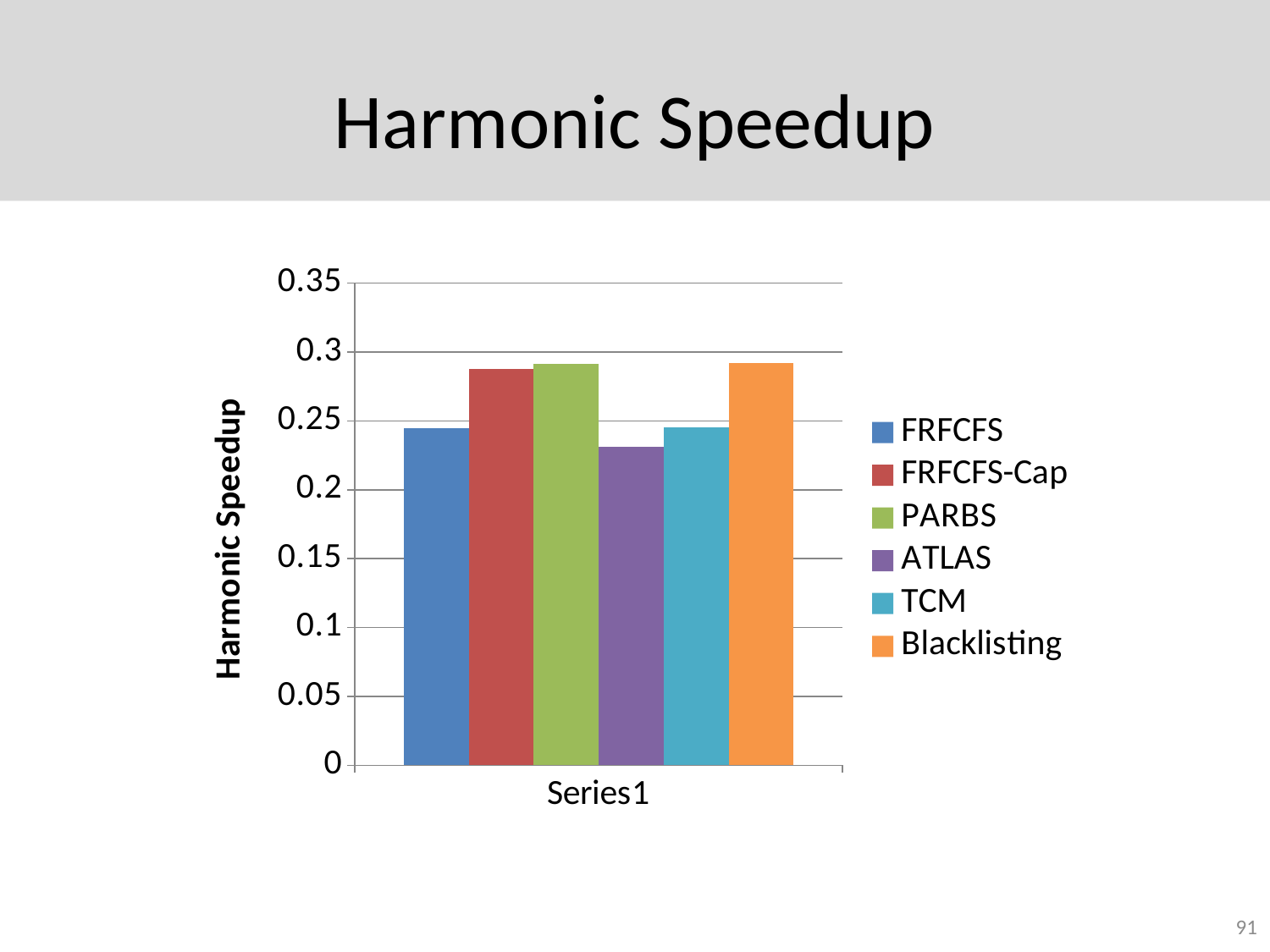
Is the value for ATLAS greater or less than 0.25? less Which is larger, the value for FRFCFS-Cap or the value for ATLAS? FRFCFS-Cap Is the value for Blacklisting greater or less than 0.25? greater Is the value for FRFCFS greater or less than 0.25? less How many series does the legend list? 6 Which series has the lowest harmonic speedup? ATLAS What kind of chart is shown on the slide? bar chart What is the label on the vertical axis of the chart? Harmonic Speedup Which is larger, the value for Blacklisting or the value for FRFCFS? Blacklisting What is the category label shown on the horizontal axis? Series1